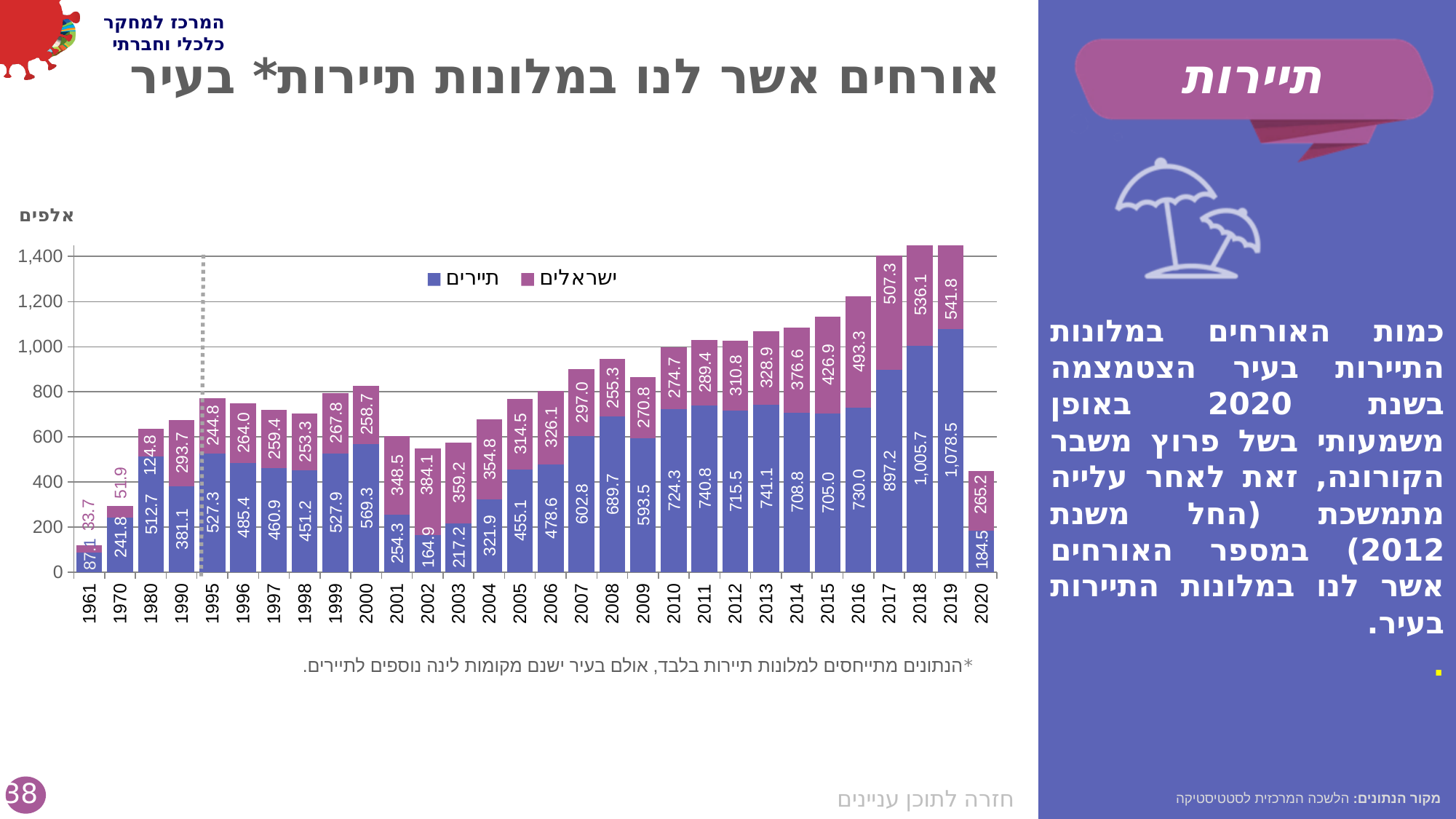
In which year is the תיירים (tourists) value highest? 2019 In 2002, which series has the larger value: תיירים (tourists) or ישראלים (Israelis)? ישראלים (Israelis) In which year is the ישראלים (Israelis) value lowest? 1961 How many years (categories) are shown on the x axis? 30 What is the value for תיירים (tourists) in 2019? 1,078.5 What is the difference between the תיירים (tourists) values for 2019 and 2020? 894.0 What is the total of the stacked bar for 2020? 449.7 How many series does the legend list? 2 What is the value for תיירים (tourists) in 2002? 164.9 What kind of chart is shown on the slide? Stacked bar chart What is the value for ישראלים (Israelis) in 2020? 265.2 Do the תיירים (tourists) values rise or fall from 2016 to 2019? Rise